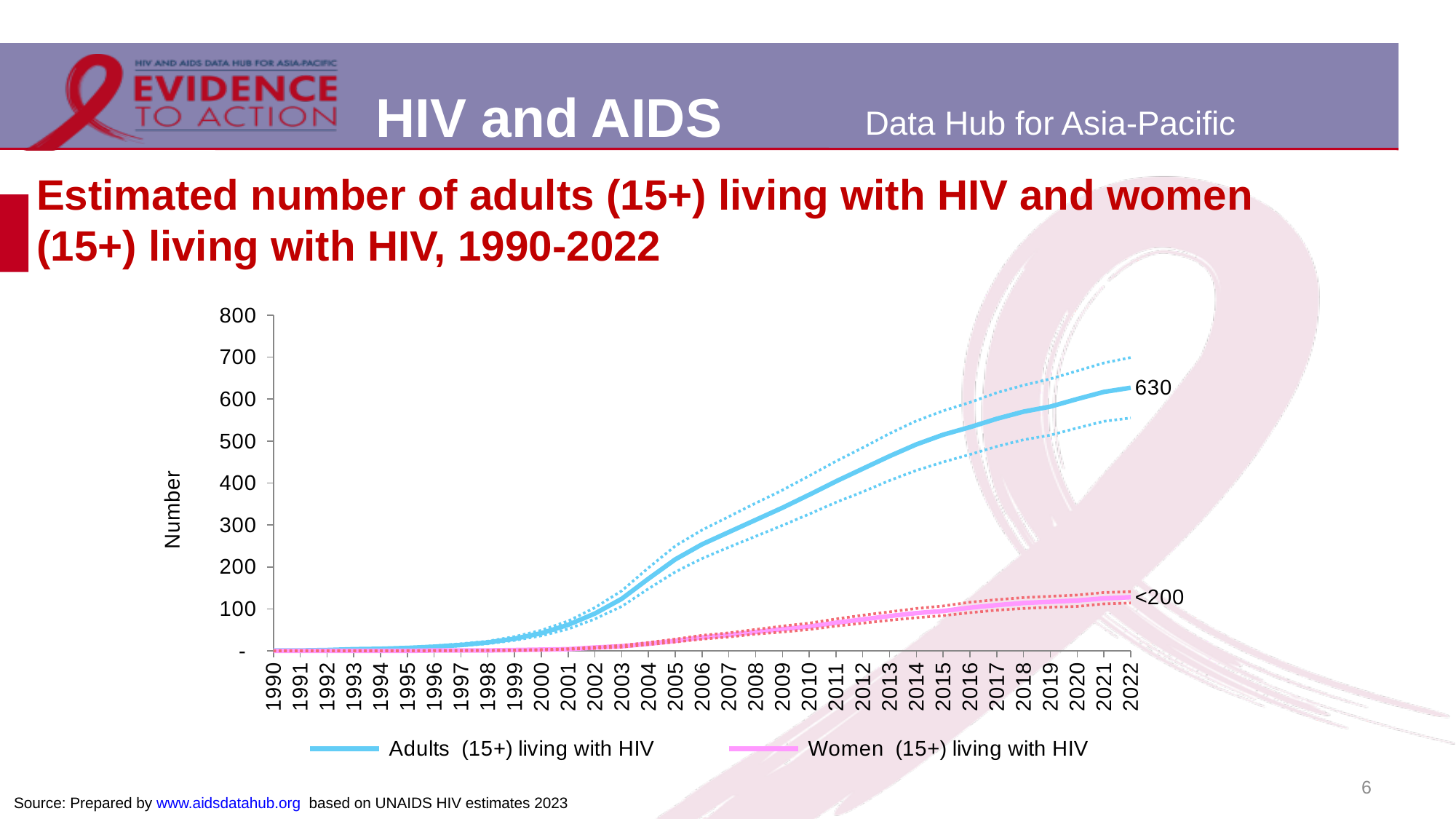
How many years are shown on the x axis? 33 In 2022, which series has the larger value: Adults (15+) living with HIV or Women (15+) living with HIV? Adults (15+) living with HIV Is the value for Adults (15+) living with HIV in 2015 greater or less than 400? greater What is the labelled value for Women (15+) living with HIV in 2022? <200 How many series does the legend list? 2 Is the value for Adults (15+) living with HIV in 2005 greater or less than 300? less What kind of chart is shown on the slide? Line chart What is the title of the vertical axis? Number Is the value for Women (15+) living with HIV in 2010 greater or less than 100? less Does the number of Adults (15+) living with HIV rise or fall from 1990 to 2022? Rise In which year is the value for Adults (15+) living with HIV highest? 2022 What is the labelled value for Adults (15+) living with HIV in 2022? 630